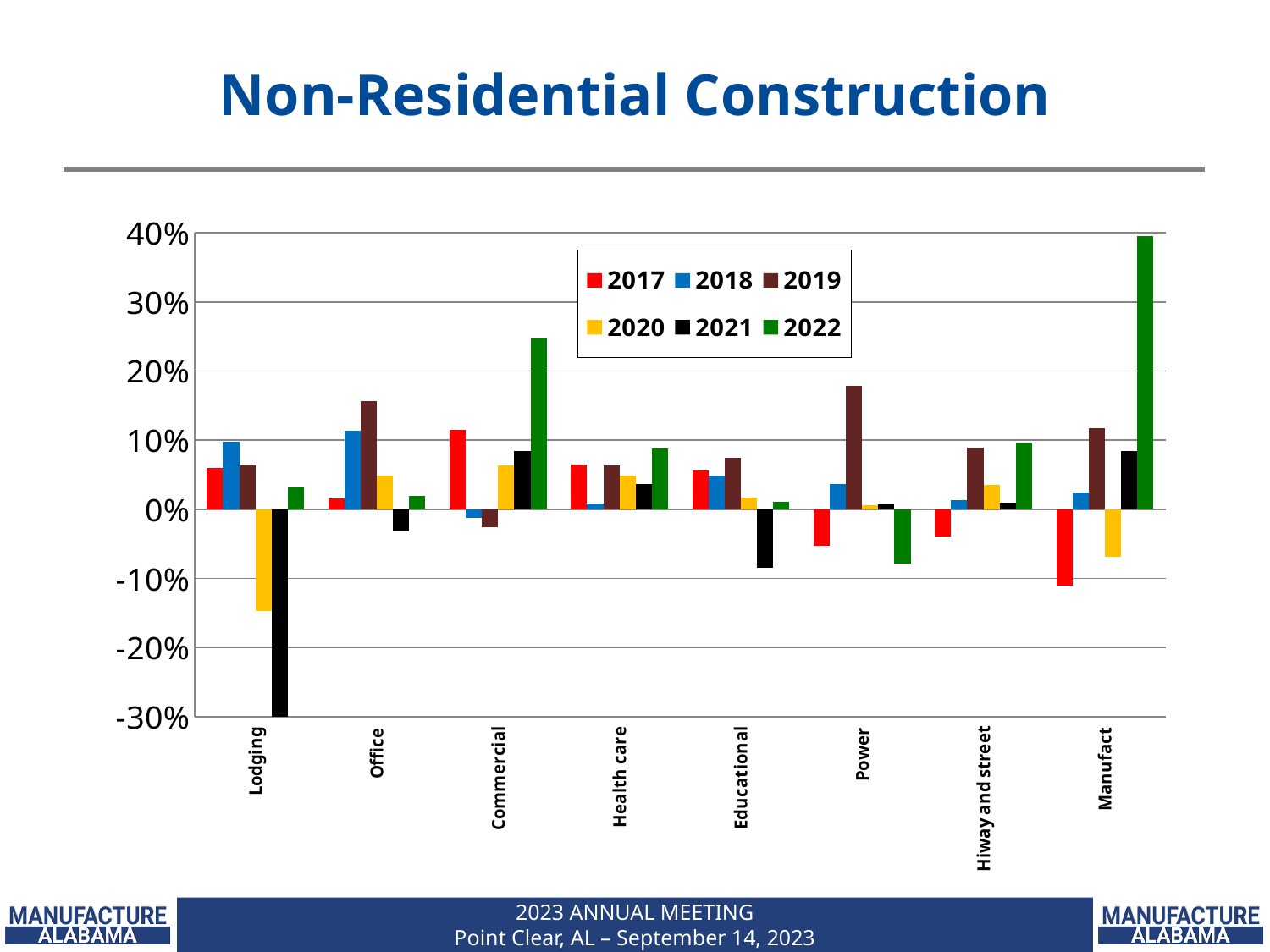
Which category has the lowest bar for 2021? Lodging What kind of chart is shown on the slide? bar chart Is the value for Lodging in 2020 greater or less than -10%? less Is the value for Power in 2019 greater or less than 10%? greater How many series does the legend list? 6 Is the value for Commercial in 2022 greater or less than 20%? greater How many categories are shown on the x axis? 8 For Office, which is larger: the 2018 value or the 2019 value? 2019 Which category has the highest bar for 2022? Manufact What is the title of the chart? Non-Residential Construction For Commercial, which is larger: the 2017 value or the 2022 value? 2022